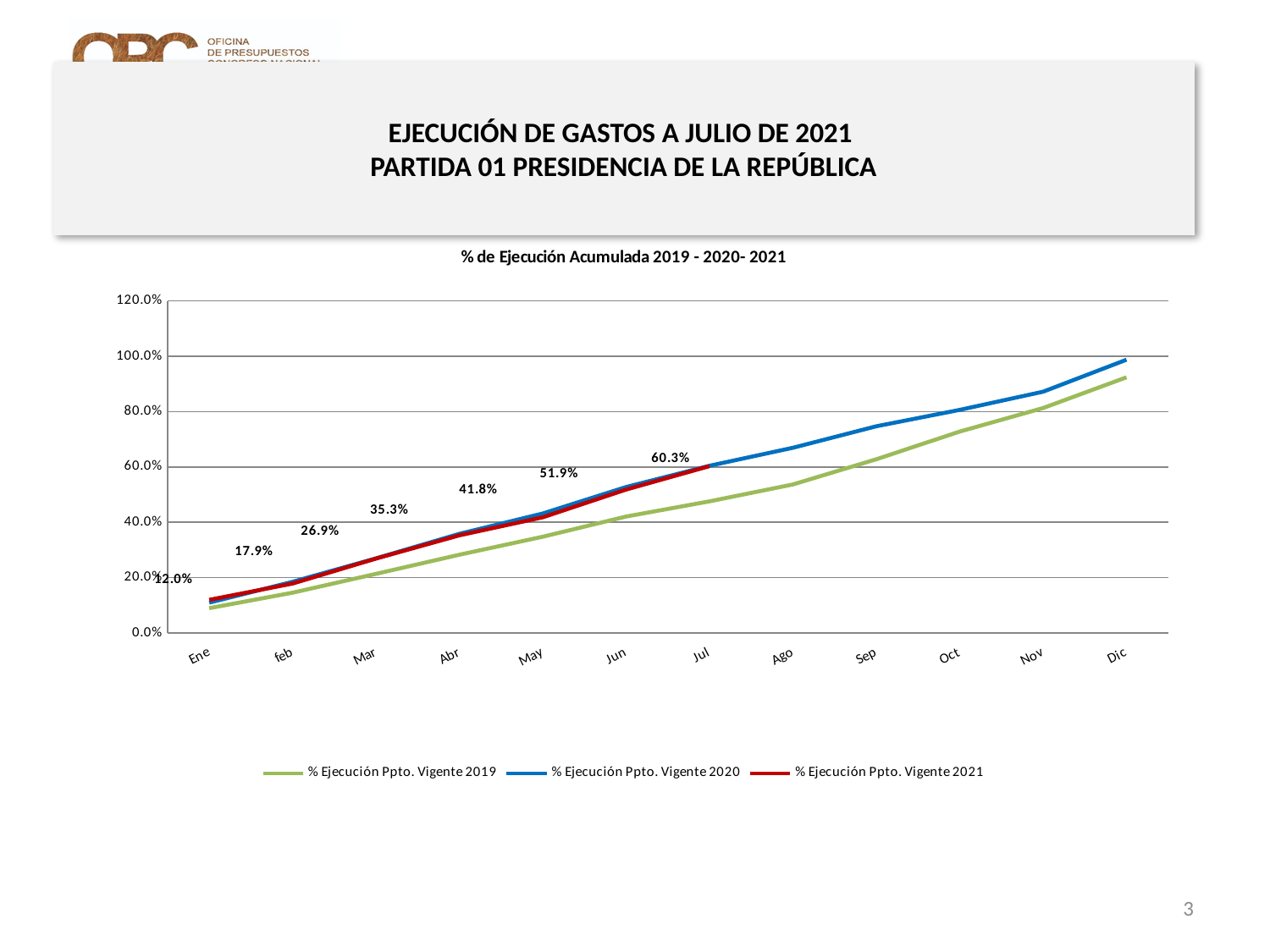
What is the value of % Ejecución Ppto. Vigente 2021 in Ene? 12.0% What is the value of % Ejecución Ppto. Vigente 2021 in Mar? 26.9% What is the value of % Ejecución Ppto. Vigente 2021 in Jul? 60.3% In Sep, which series is higher: % Ejecución Ppto. Vigente 2019 or % Ejecución Ppto. Vigente 2020? % Ejecución Ppto. Vigente 2020 Does the % Ejecución Ppto. Vigente 2019 series rise or fall from Ene to Dic? Rise How many series does the legend list? 3 What is the difference between the 2021 values for May and Abr? 6.5% How many months are shown on the x axis? 12 What is the title of the chart? % de Ejecución Acumulada 2019 - 2020- 2021 What is the difference between the 2021 values for Jul and Jun? 8.4% Is the value for % Ejecución Ppto. Vigente 2020 in Dic greater or less than 80.0%? greater What type of chart is shown on the slide? Line chart